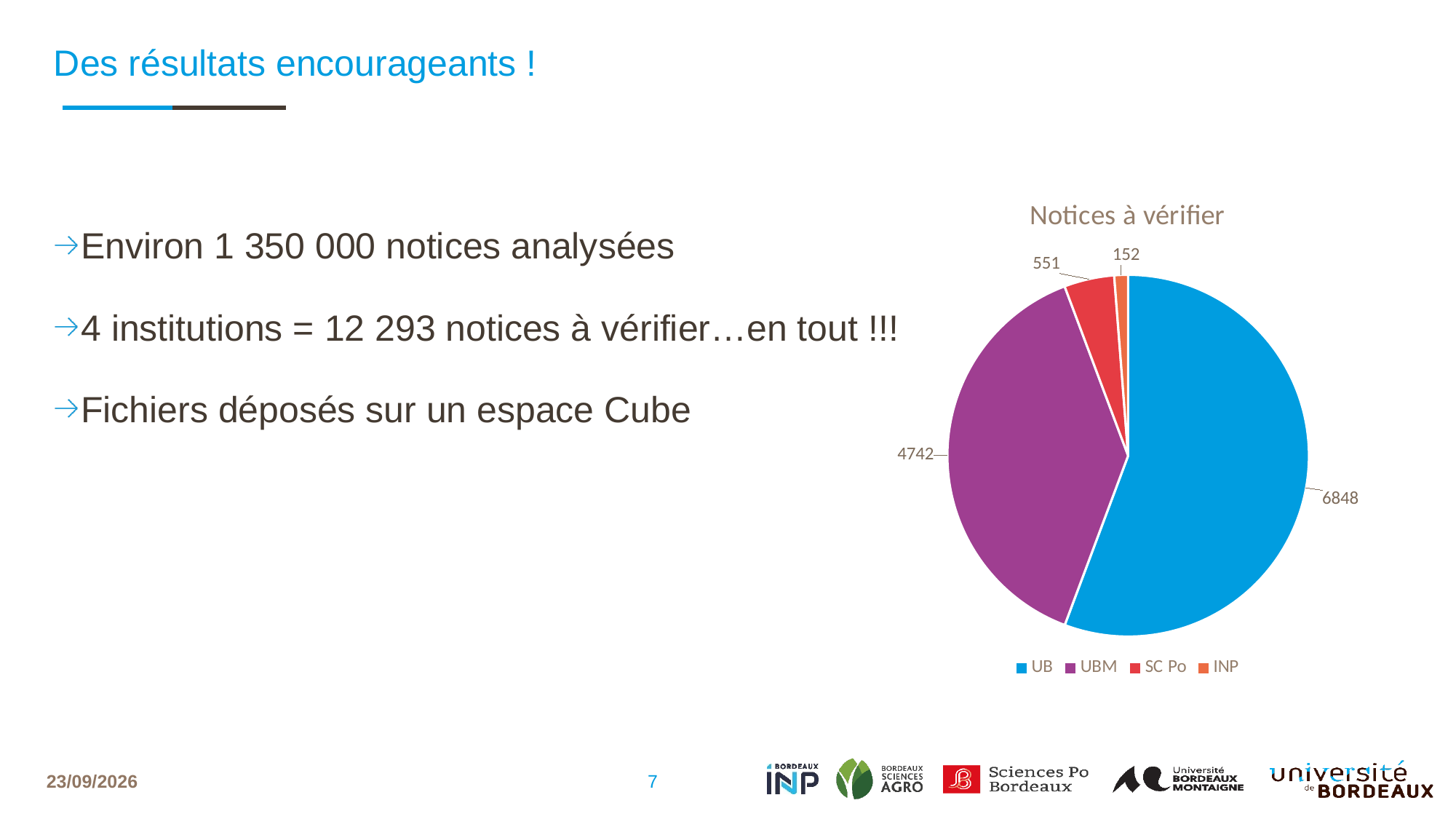
Which institution has the smallest slice of the pie chart? INP How many slices does the pie chart have? 4 What is the difference between the values for UB and UBM? 2106 What is the title of the chart? Notices à vérifier What is the value for SC Po in the pie chart? 551 Which is larger, the value for SC Po or the value for INP? SC Po What is the value for INP in the pie chart? 152 What is the value for UB in the pie chart? 6848 What is the value for UBM in the pie chart? 4742 What type of chart is shown on the slide? pie chart Which institution has the largest slice of the pie chart? UB What is the total of all four slices in the pie chart? 12293